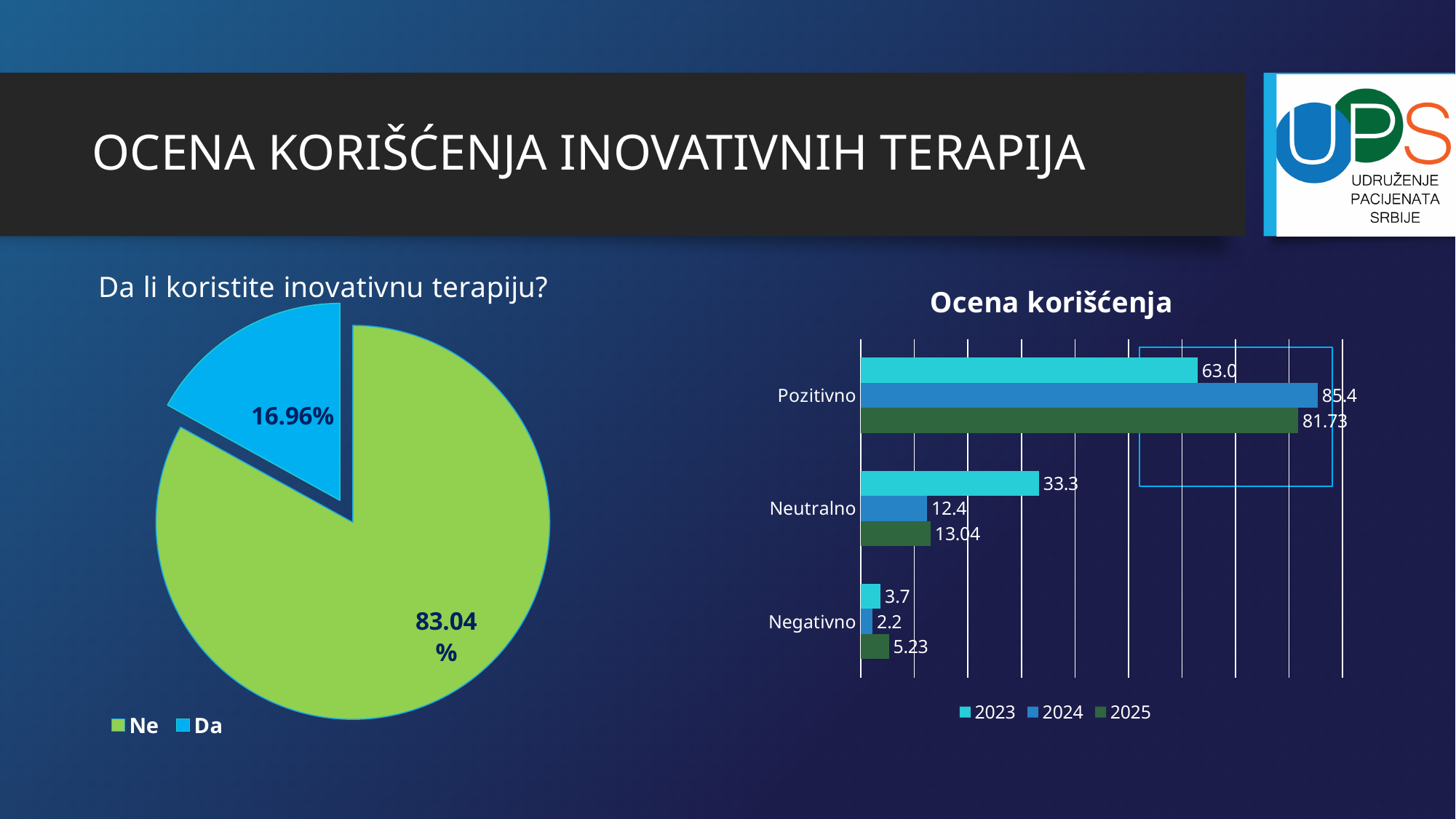
In the pie chart 'Da li koristite inovativnu terapiju?', what share is labelled for 'Da'? 16.96% In the 'Ocena korišćenja' chart, which year has the lowest value for 'Negativno'? 2024 How many series does the legend of the 'Ocena korišćenja' chart list? 3 In the 'Ocena korišćenja' chart, what is the difference between the 2024 and 2023 values for 'Pozitivno'? 22.4 In the pie chart 'Da li koristite inovativnu terapiju?', what share is labelled for 'Ne'? 83.04% In the 'Ocena korišćenja' chart, which year has the highest value for 'Pozitivno'? 2024 In the 'Ocena korišćenja' chart, what is the value for 'Negativno' in 2025? 5.23 In the 'Ocena korišćenja' chart, what is the value for 'Neutralno' in 2023? 33.3 In the 'Ocena korišćenja' chart, what is the value for 'Pozitivno' in 2024? 85.4 What kind of chart is the chart on the left of the slide? Pie chart What kind of chart is 'Ocena korišćenja'? Bar chart In the pie chart 'Da li koristite inovativnu terapiju?', which slice is larger, 'Ne' or 'Da'? Ne